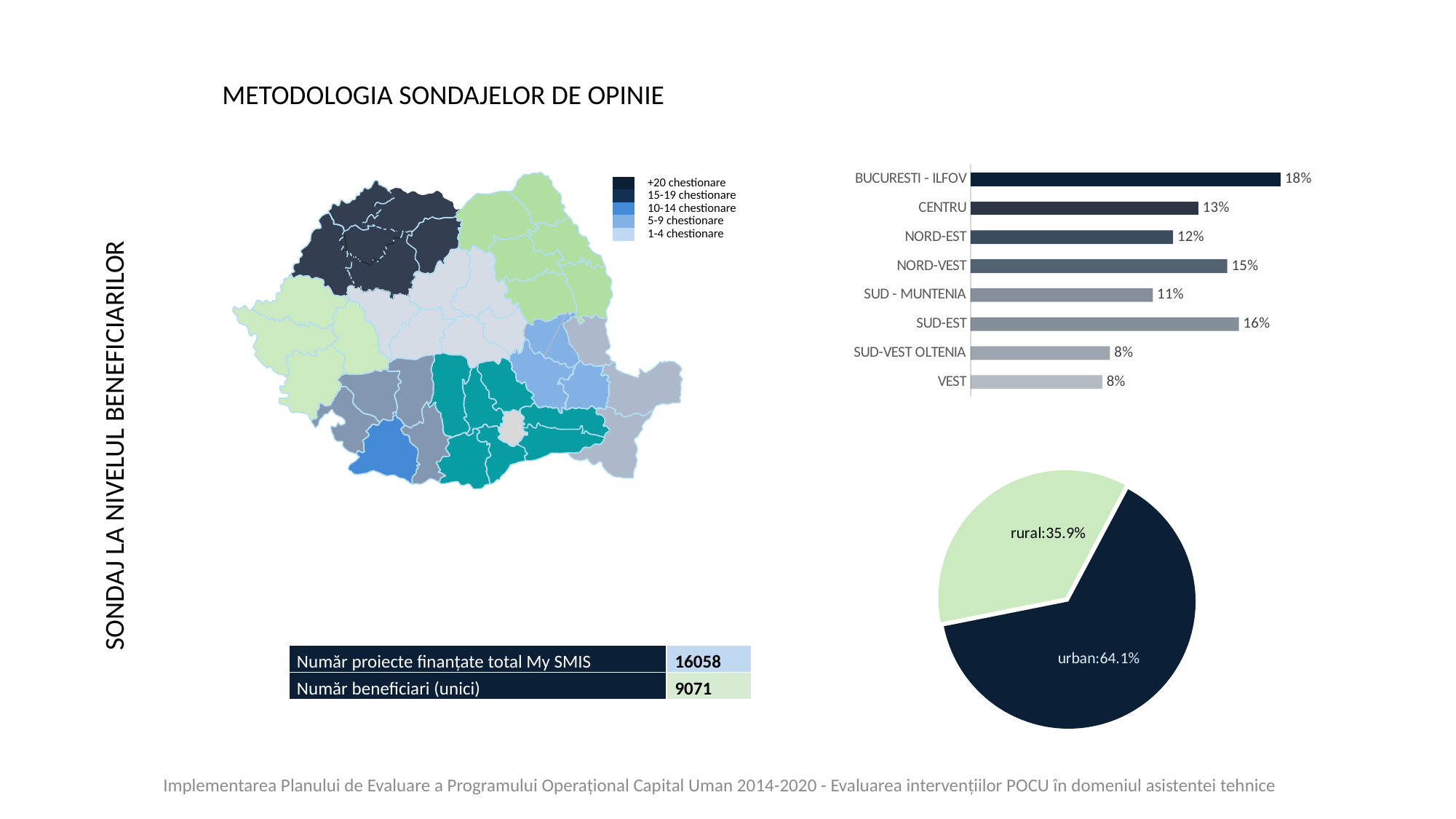
In the bar chart of regions on the right, what is the value for SUD - MUNTENIA? 11% In the bar chart of regions on the right, how many regions are shown? 8 In the bar chart of regions on the right, what is the value for BUCURESTI - ILFOV? 18% In the bar chart of regions on the right, what is the difference between SUD-EST and CENTRU? 3% In the bar chart of regions on the right, what is the value for NORD-VEST? 15% In the bar chart of regions on the right, which region has the highest value? BUCURESTI - ILFOV In the pie chart at the bottom right, what is the share for urban? 64.1% In the bar chart of regions on the right, which is larger, NORD-EST or NORD-VEST? NORD-VEST In the pie chart at the bottom right, what is the share for rural? 35.9% In the pie chart at the bottom right, how many slices are there? 2 What kind of chart is the chart of regions on the right of the slide? bar chart In the pie chart at the bottom right, which slice is larger, rural or urban? urban